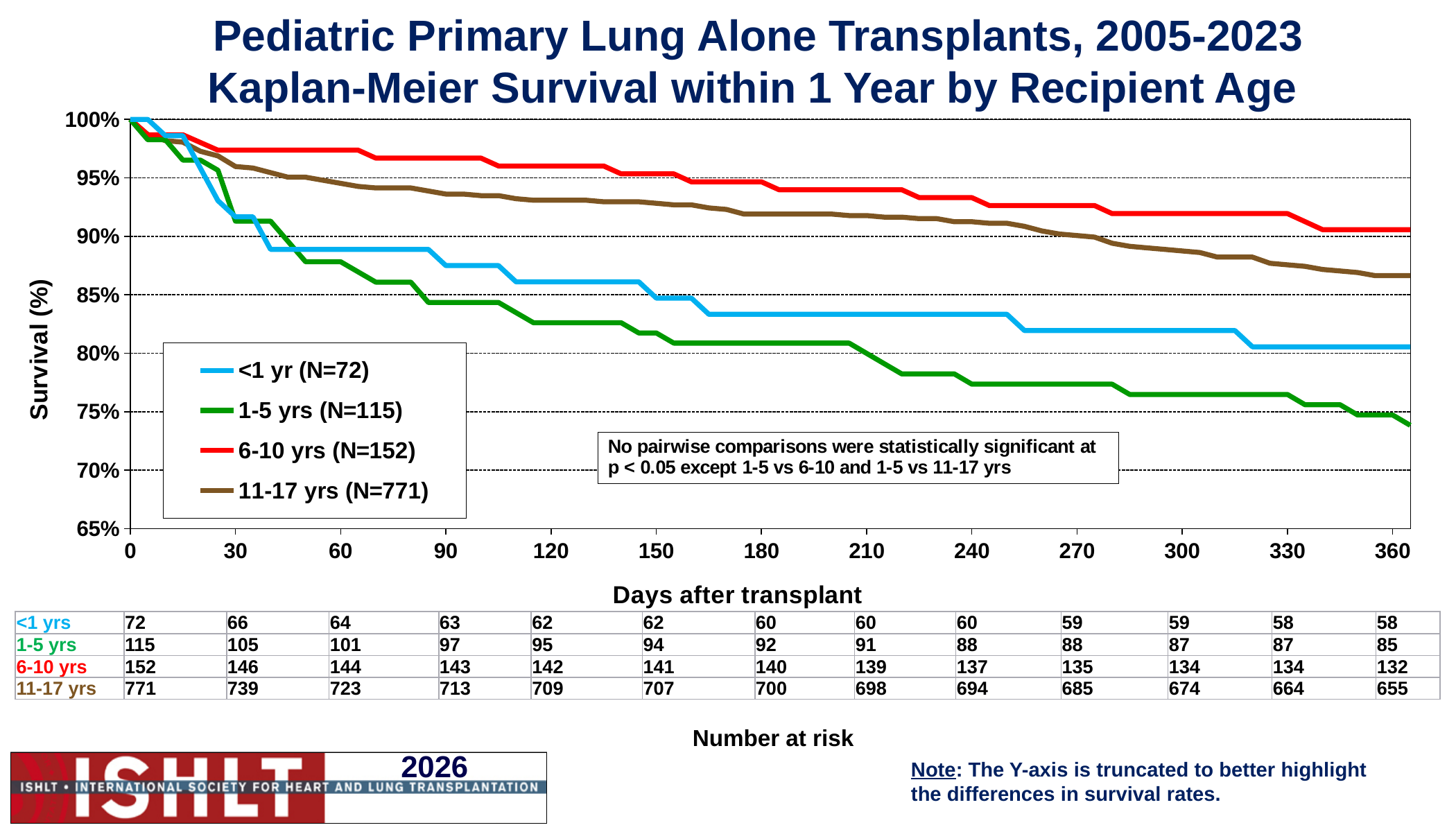
What kind of chart is shown on the slide? Line chart Is the survival for the 1-5 yrs group at 360 days greater or less than 80%? less Which recipient age group has the highest survival at 360 days? 6-10 yrs Is the survival for the 6-10 yrs group at 360 days greater or less than 85%? greater According to the legend, what is the N for the 6-10 yrs group? N=152 What is the title of the chart? Pediatric Primary Lung Alone Transplants, 2005-2023 Kaplan-Meier Survival within 1 Year by Recipient Age Which recipient age group has the lowest survival at 360 days? 1-5 yrs At 360 days, is survival higher for the 6-10 yrs group or the 1-5 yrs group? 6-10 yrs Is the survival for the <1 yr group at 360 days greater or less than 85%? less Do the survival curves rise or fall as days after transplant increase? Fall How many series does the legend list? 4